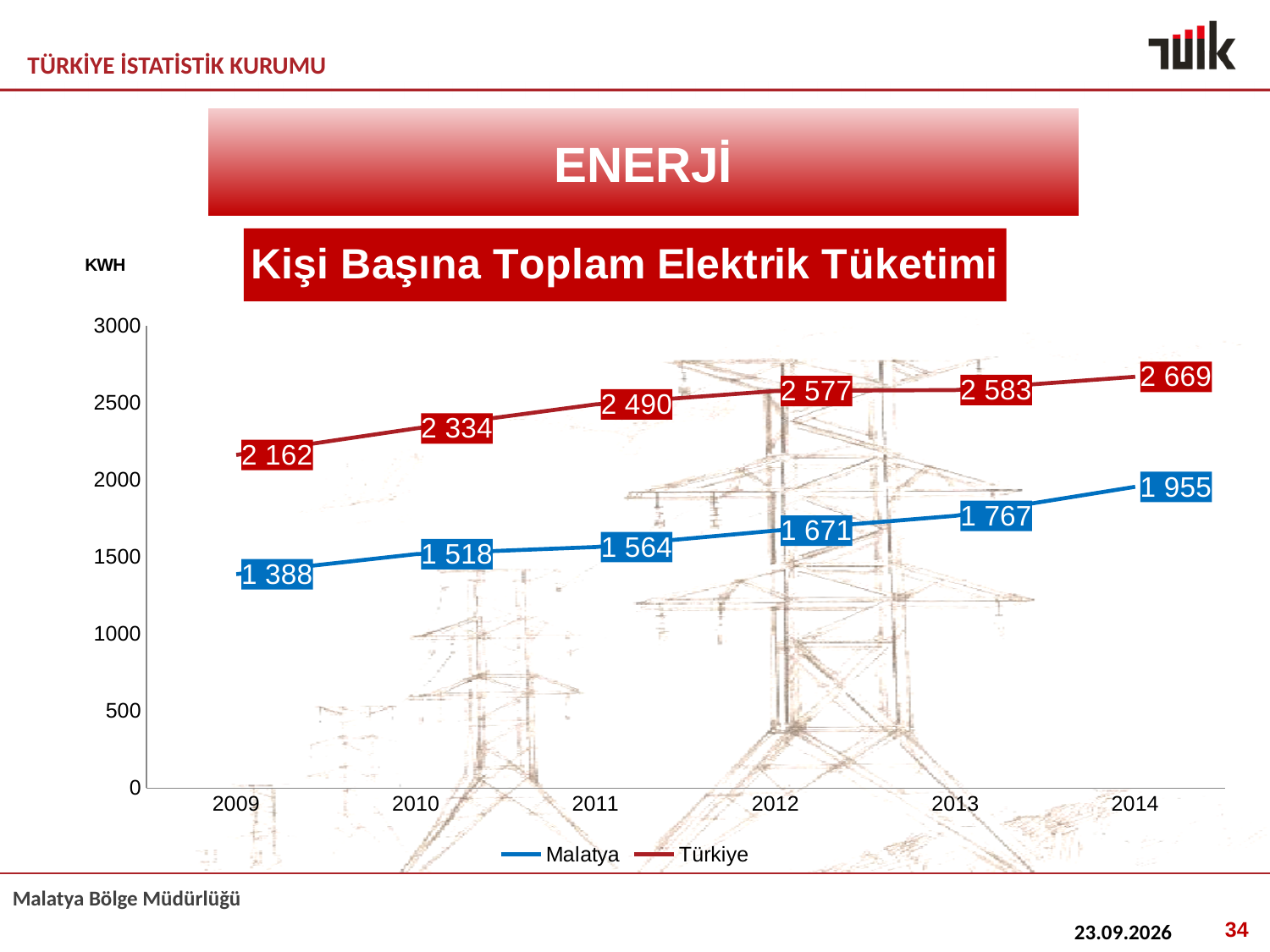
What is the difference between the Türkiye and Malatya values in 2014? 714 Is the value for Malatya in 2014 greater or less than 2000? less In which year is the Türkiye value lowest? 2009 What is the value for Türkiye in 2014? 2 669 Which is larger in 2012, the Malatya value or the Türkiye value? Türkiye What is the value for Malatya in 2009? 1 388 How many years are shown on the x axis? 6 What kind of chart is this? line chart What is the value for Türkiye in 2011? 2 490 In which year is the Malatya value highest? 2014 What is the value for Malatya in 2013? 1 767 How many series does the legend list? 2